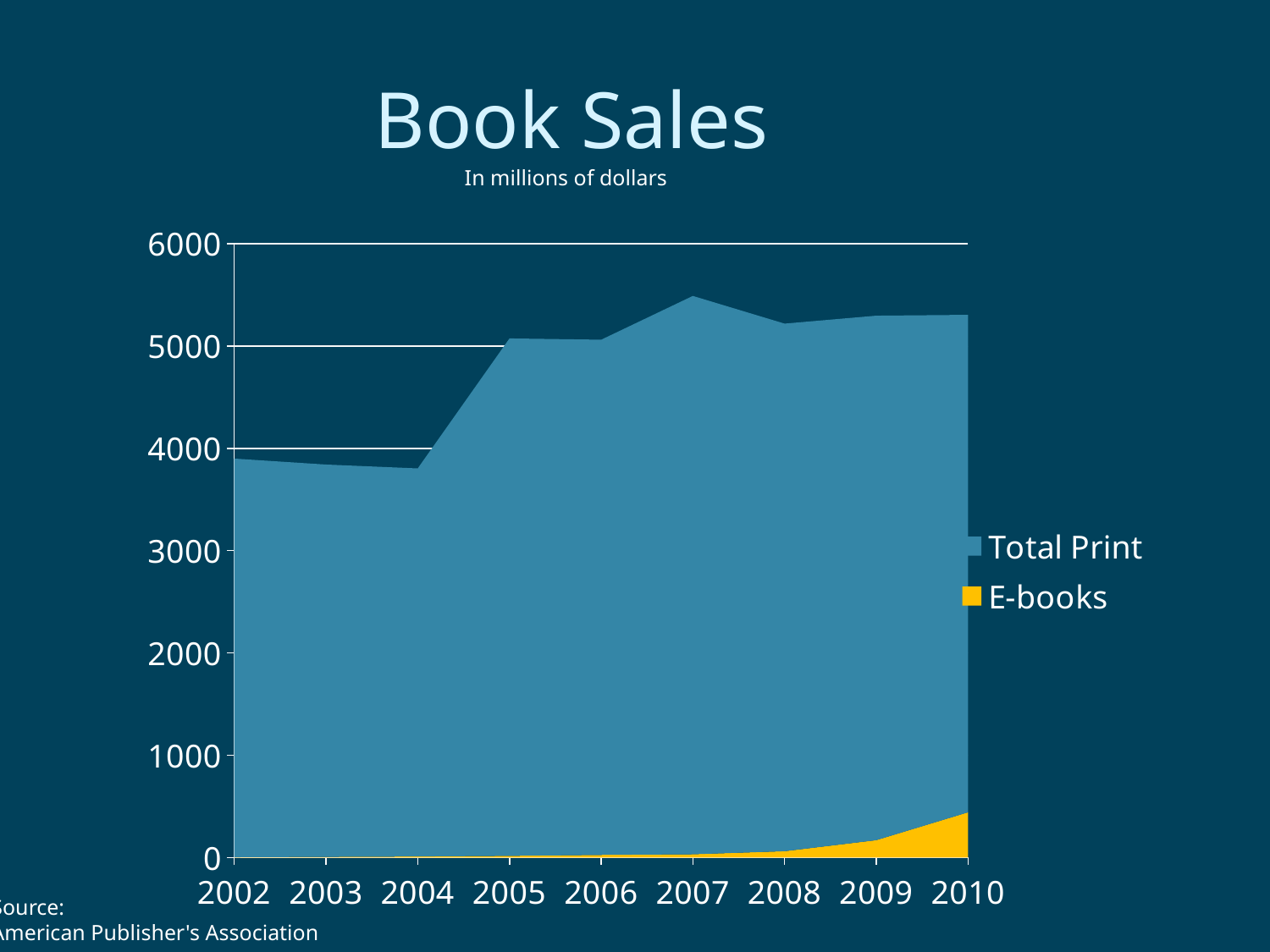
Which year has the larger Total Print value, 2004 or 2005? 2005 What kind of chart is shown on the slide? Area chart Is the Total Print value for 2007 greater or less than 5000? greater Is the E-books value for 2010 greater or less than 1000? less How many years are plotted along the x axis? 9 How many series does the legend list? 2 In what units are the values shown, according to the subtitle? In millions of dollars In which year does Total Print reach its highest value? 2007 Do E-books sales rise or fall from 2002 to 2010? Rise In which year is the E-books value highest? 2010 What is the title of the chart? Book Sales Is the Total Print value for 2002 greater or less than 4000? less